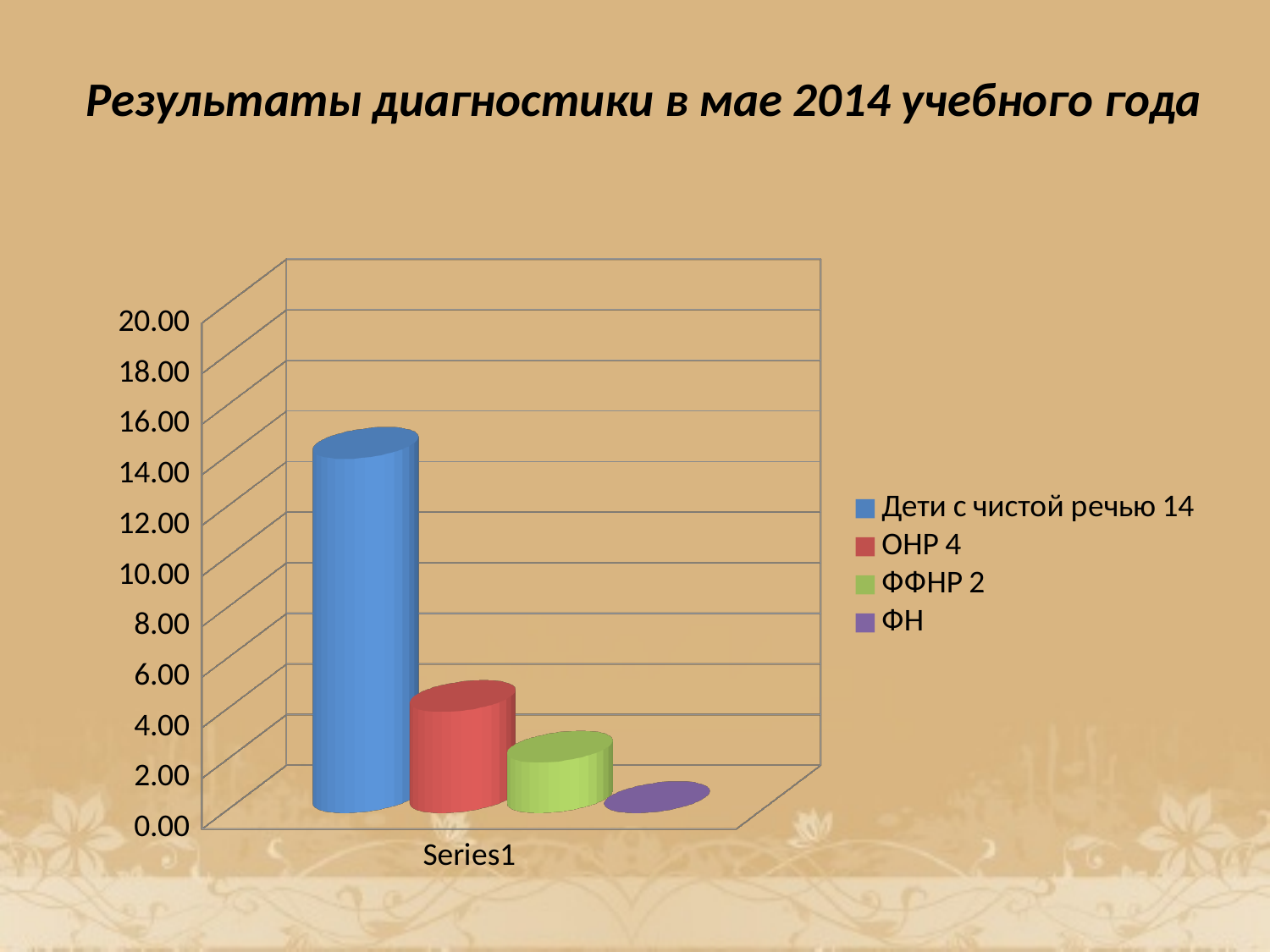
Is the value for ФН greater or less than 2.00? less What kind of chart is shown on the slide? bar chart Is the value for ОНР 4 greater or less than 8.00? less Which series has the tallest bar in the chart? Дети с чистой речью 14 Which series has the lowest value in the chart? ФН Is the value for ФФНР 2 greater or less than 6.00? less What is the title of the slide containing the chart? Результаты диагностики в мае 2014 учебного года Which is larger, the value for ОНР 4 or the value for ФФНР 2? ОНР 4 Which is larger, the value for Дети с чистой речью 14 or the value for ОНР 4? Дети с чистой речью 14 How many series does the chart legend list? 4 What label appears on the horizontal axis of the chart? Series1